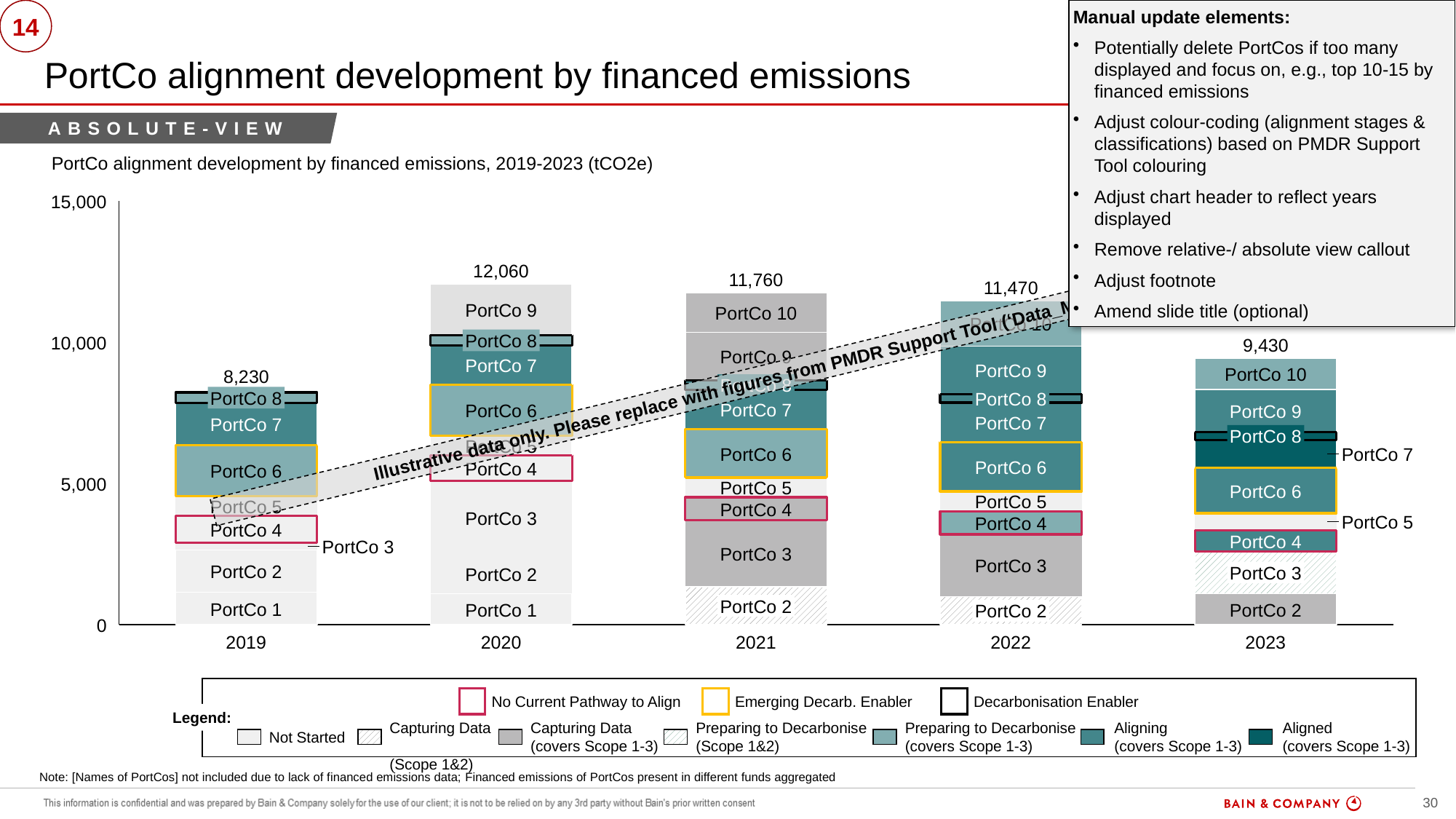
What is the total value labelled above the 2023 bar? 9,430 What is the difference between the 2020 total and the 2019 total? 3,830 How many years are shown on the x axis? 5 What is the total financed emissions value shown for 2020? 12,060 Is the total for 2023 greater or less than 10,000? less Which PortCo is the top segment of the 2023 bar? PortCo 10 Which year has the lowest total financed emissions? 2019 What is the difference between the 2021 total and the 2022 total? 290 Which year has the highest total financed emissions? 2020 How does the total change from 2020 to 2023? It falls each year What kind of chart is shown on the slide? Stacked bar chart Which year has the larger total, 2021 or 2022? 2021